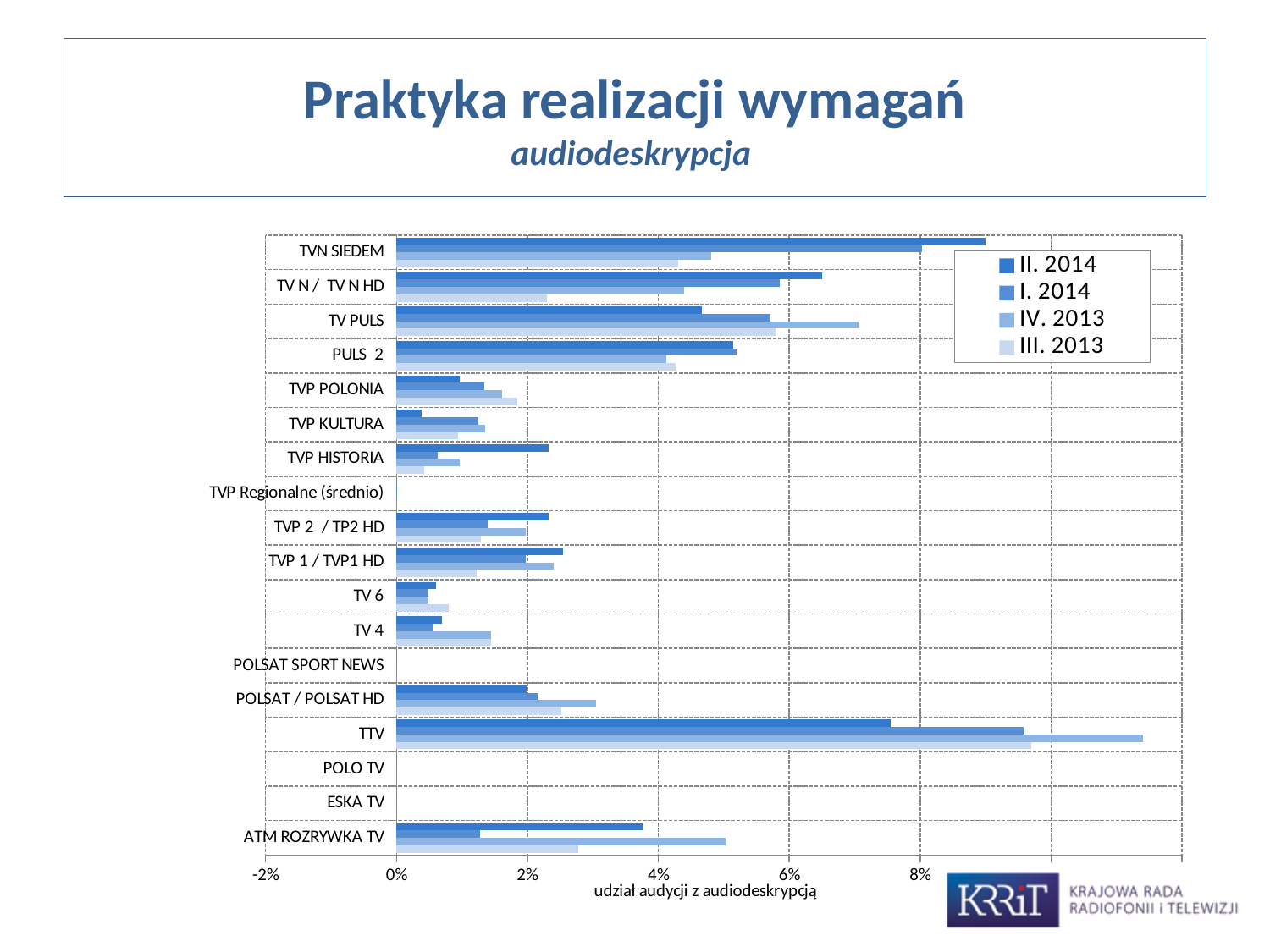
Is the II. 2014 value for TVP KULTURA greater or less than 2%? less What is the label of the horizontal axis? udział audycji z audiodeskrypcją How many series does the legend list? 4 Which channel has the highest III. 2013 value? TTV Is the II. 2014 value for TVN SIEDEM greater or less than 8%? greater How many channel categories are shown on the vertical axis? 18 For TTV, which is larger, the III. 2013 value or the II. 2014 value? III. 2013 What kind of chart is shown on the slide? bar chart Is the III. 2013 value for TTV greater or less than 8%? greater Which has the larger II. 2014 value, TVN SIEDEM or TV N / TV N HD? TVN SIEDEM Which channel has the highest II. 2014 value? TVN SIEDEM